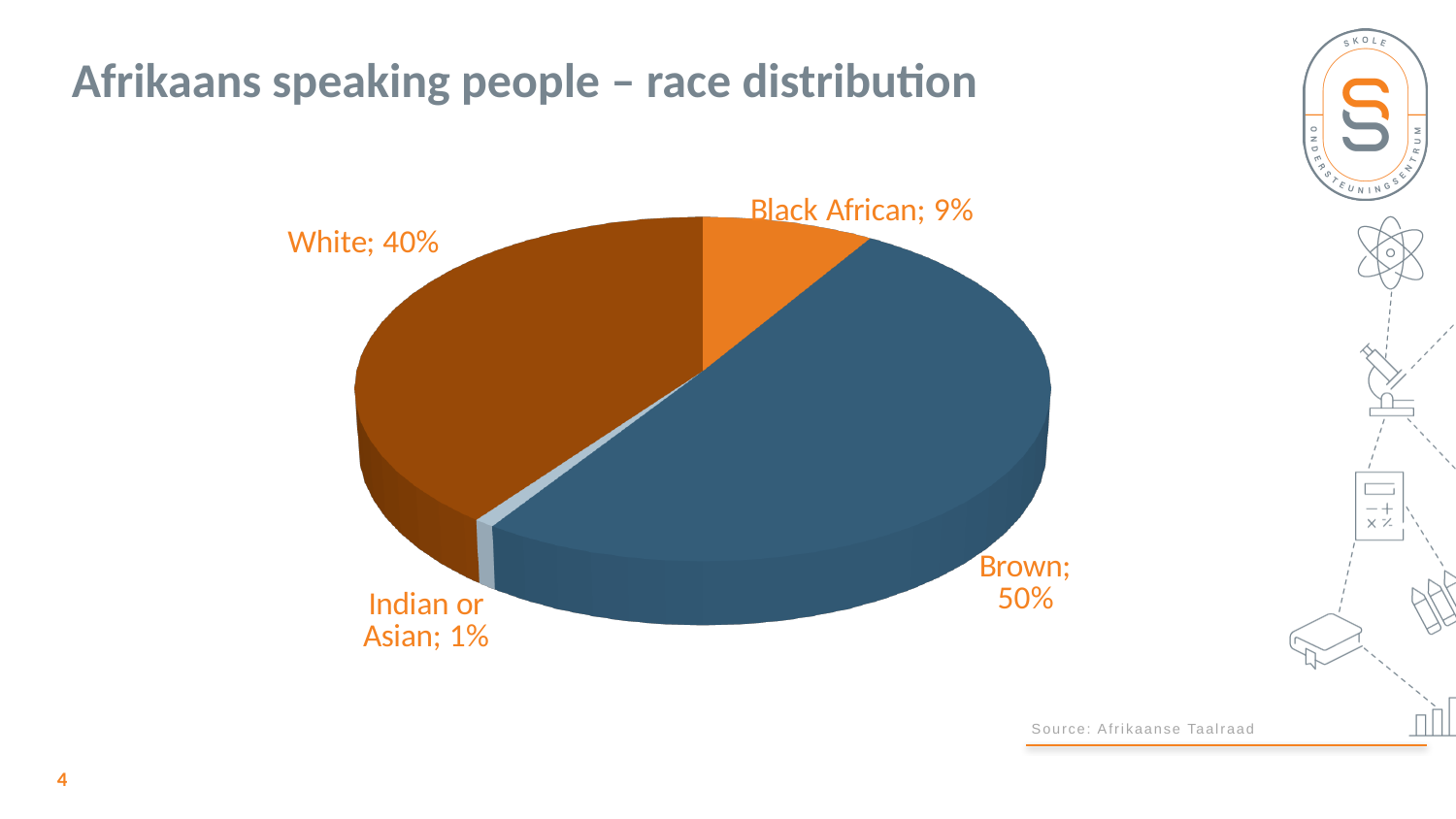
What share of Afrikaans speaking people is Brown? 50% What share of Afrikaans speaking people is Indian or Asian? 1% Which race group has the largest share of Afrikaans speaking people? Brown What is the difference in percentage points between the Brown and White shares? 10 Which race group has the smallest share of Afrikaans speaking people? Indian or Asian What kind of chart is shown on the slide? Pie chart What share of Afrikaans speaking people is Black African? 9% How many race groups are shown in the pie chart? 4 Which is larger, the share for White or the share for Black African? White What is the difference in percentage points between the Black African and Indian or Asian shares? 8 What share of Afrikaans speaking people is White? 40% What is the title of the chart on the slide? Afrikaans speaking people – race distribution